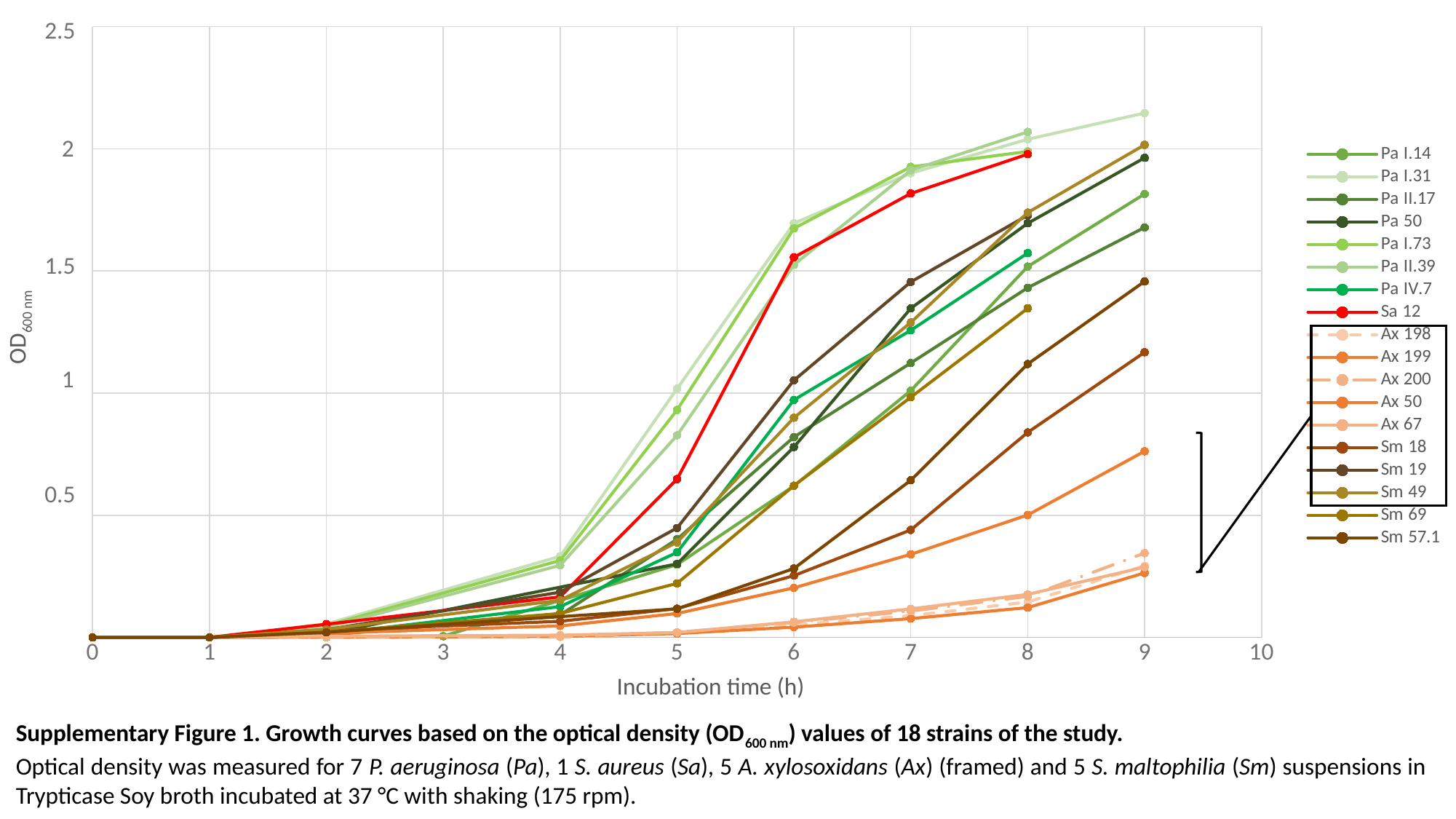
At 8 hours, which series has the larger value, Sa 12 or Ax 199? Sa 12 Is the value for Sa 12 at 5 hours greater or less than 0.5? greater How many Ax series are framed in the legend? 5 Do the OD values for Pa I.31 rise or fall as incubation time increases? rise Is the value for Ax 199 at 9 hours greater or less than 1? less Is the value for Sm 18 at 9 hours greater or less than 1? greater Which series is drawn in red? Sa 12 Which series has the highest OD value at 9 hours of incubation? Pa I.31 What kind of chart is shown on the slide? line chart What is the label of the x axis? Incubation time (h) How many series does the legend list? 18